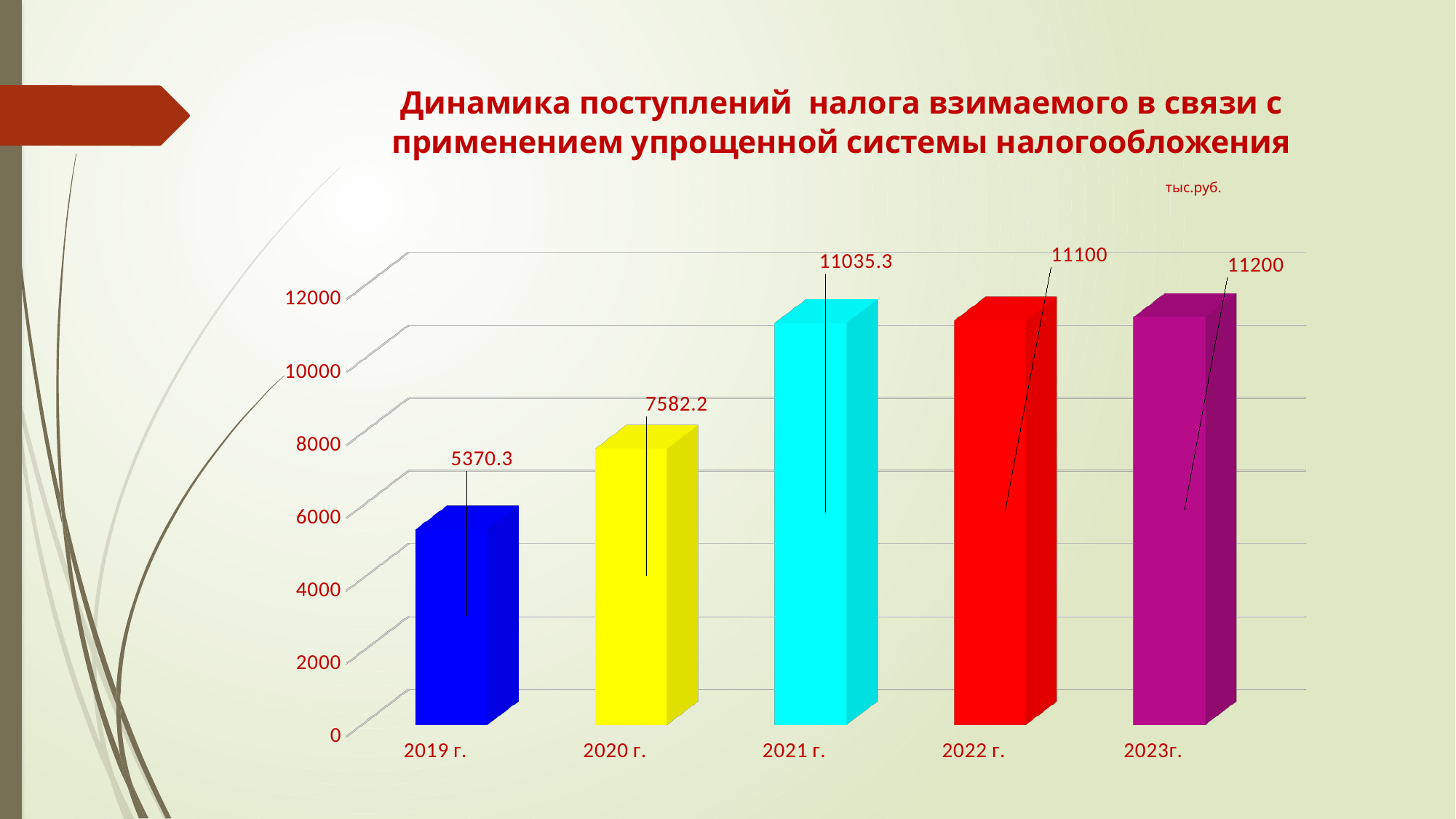
What is the value for 2021 г.? 11035.3 Which is larger, the value for 2020 г. or the value for 2021 г.? 2021 г. What is the value for 2023г.? 11200 What is the value for 2019 г.? 5370.3 Which year has the highest value? 2023г. Which year has the lowest value? 2019 г. Do the values rise or fall from 2019 г. to 2023г.? rise How many years are shown on the x axis? 5 Is the value for 2019 г. greater or less than 6000? less What is the difference between the values for 2020 г. and 2019 г.? 2211.9 What kind of chart is shown on the slide? bar chart What is the difference between the values for 2023г. and 2022 г.? 100